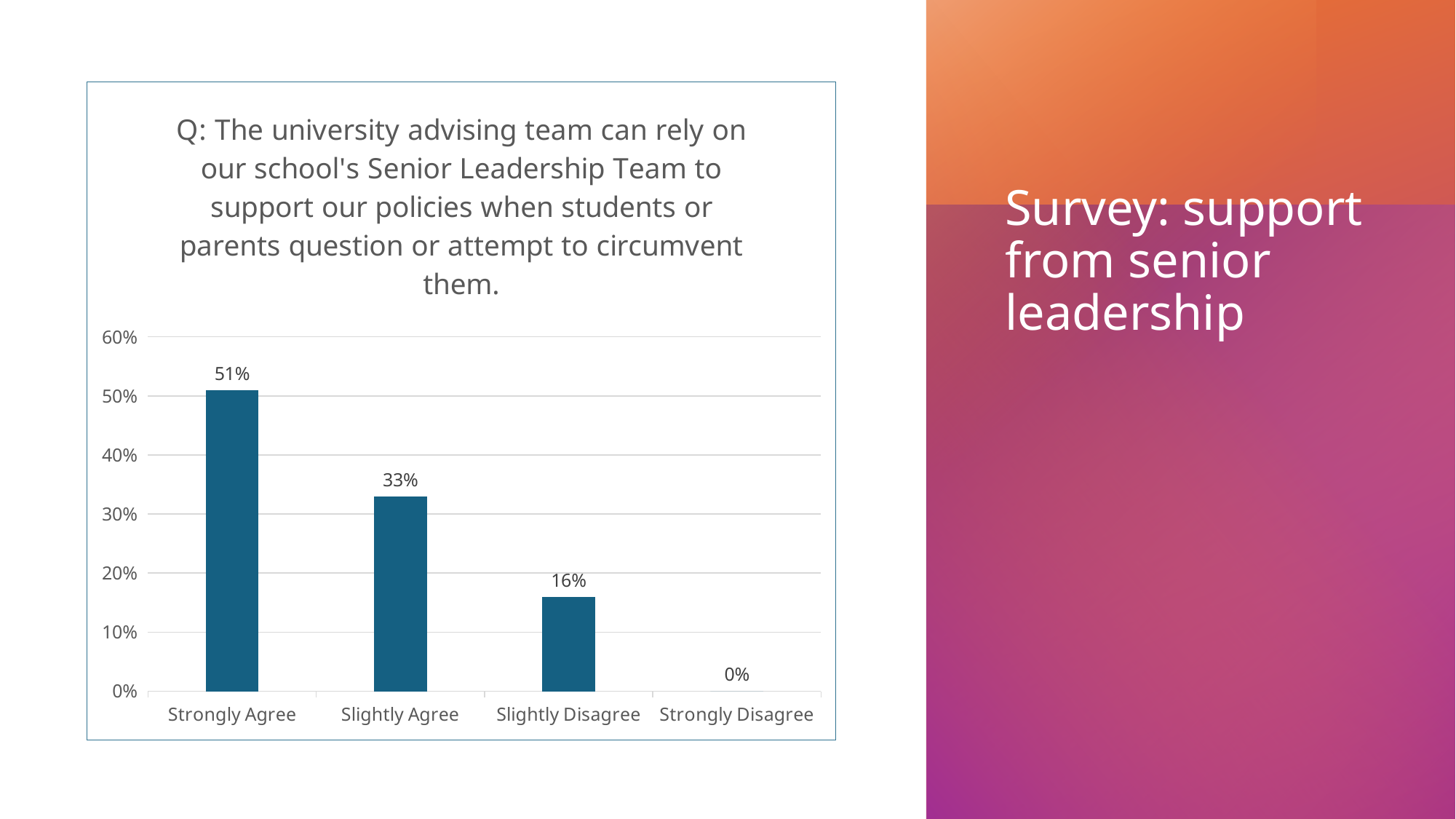
Which response category has the highest percentage? Strongly Agree What percentage of respondents answered Strongly Agree? 51% What percentage of respondents answered Strongly Disagree? 0% Is the value for Strongly Agree greater or less than 50%? greater What kind of chart is shown on the slide? Bar chart Which response category has the lowest percentage? Strongly Disagree What is the difference in percentage points between Strongly Agree and Slightly Agree? 18% Do the values rise or fall moving from left to right along the x axis? Fall How many response categories are shown on the x axis? 4 What percentage of respondents answered Slightly Disagree? 16% What percentage of respondents answered Slightly Agree? 33% Which is larger, the value for Slightly Agree or the value for Slightly Disagree? Slightly Agree